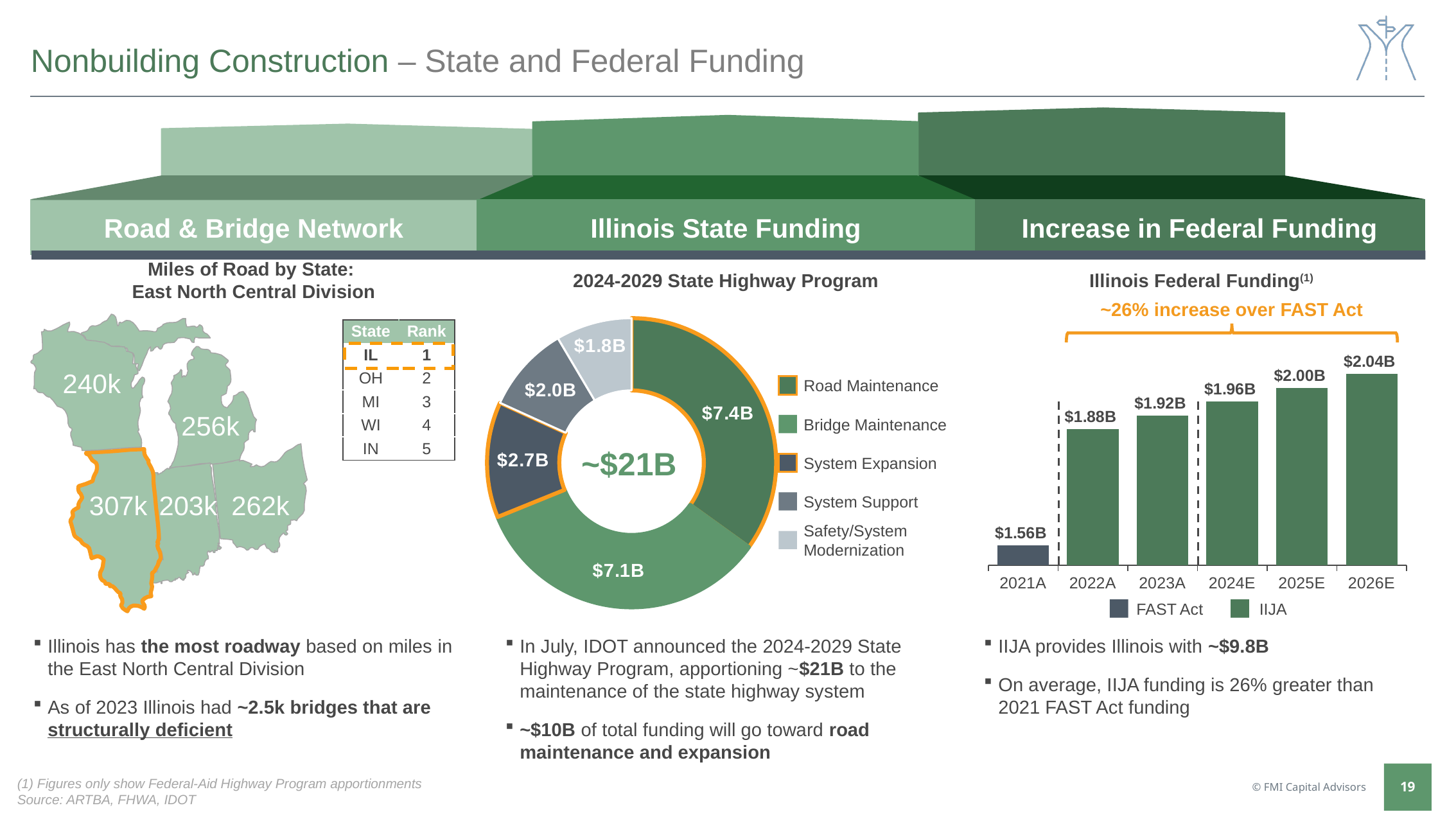
In the 2024-2029 State Highway Program chart, which category has the largest value? Road Maintenance In the Illinois Federal Funding chart, what is the difference between the 2026E and 2021A values? $0.48B In the 2024-2029 State Highway Program chart, which category has the smallest value? Safety/System Modernization In the 2024-2029 State Highway Program chart, what is the value for Road Maintenance? $7.4B In the 2024-2029 State Highway Program chart, how much larger is Road Maintenance than Bridge Maintenance? $0.3B How many series does the legend of the Illinois Federal Funding chart list? 2 In the 2024-2029 State Highway Program chart, what is the value for System Support? $2.0B In the Illinois Federal Funding chart, what is the value for 2021A? $1.56B In the Illinois Federal Funding chart, do the values rise or fall from 2021A to 2026E? Rise How many categories are shown in the 2024-2029 State Highway Program chart? 5 In the Illinois Federal Funding chart, what is the value for 2026E? $2.04B What kind of chart is the 2024-2029 State Highway Program chart? Doughnut chart